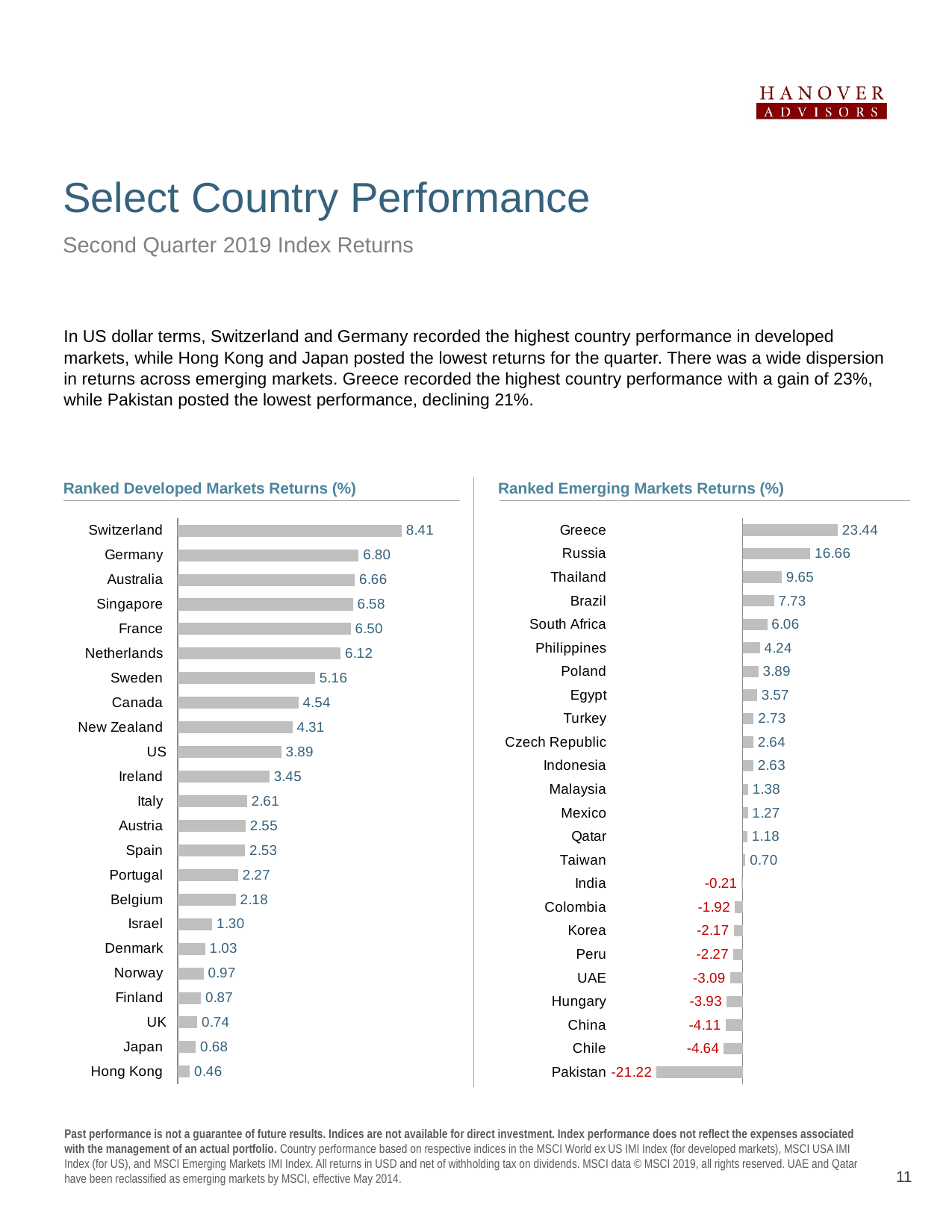
In the Ranked Developed Markets Returns (%) chart, which is larger, the value for Canada or the value for Sweden? Sweden In the Ranked Emerging Markets Returns (%) chart, which country has the highest return? Greece In the Ranked Emerging Markets Returns (%) chart, what is the value for Pakistan? -21.22 In the Ranked Developed Markets Returns (%) chart, which country has the lowest return? Hong Kong In the Ranked Developed Markets Returns (%) chart, what is the difference between the values for Switzerland and Japan? 7.73 What type of chart is the Ranked Developed Markets Returns (%) chart? Bar chart In the Ranked Emerging Markets Returns (%) chart, what is the difference between the values for Greece and Russia? 6.78 How many countries are shown in the Ranked Emerging Markets Returns (%) chart? 24 In the Ranked Developed Markets Returns (%) chart, which country has the highest return? Switzerland In the Ranked Emerging Markets Returns (%) chart, what is the value for Taiwan? 0.70 How many countries are shown in the Ranked Developed Markets Returns (%) chart? 23 In the Ranked Developed Markets Returns (%) chart, what is the value for Germany? 6.80